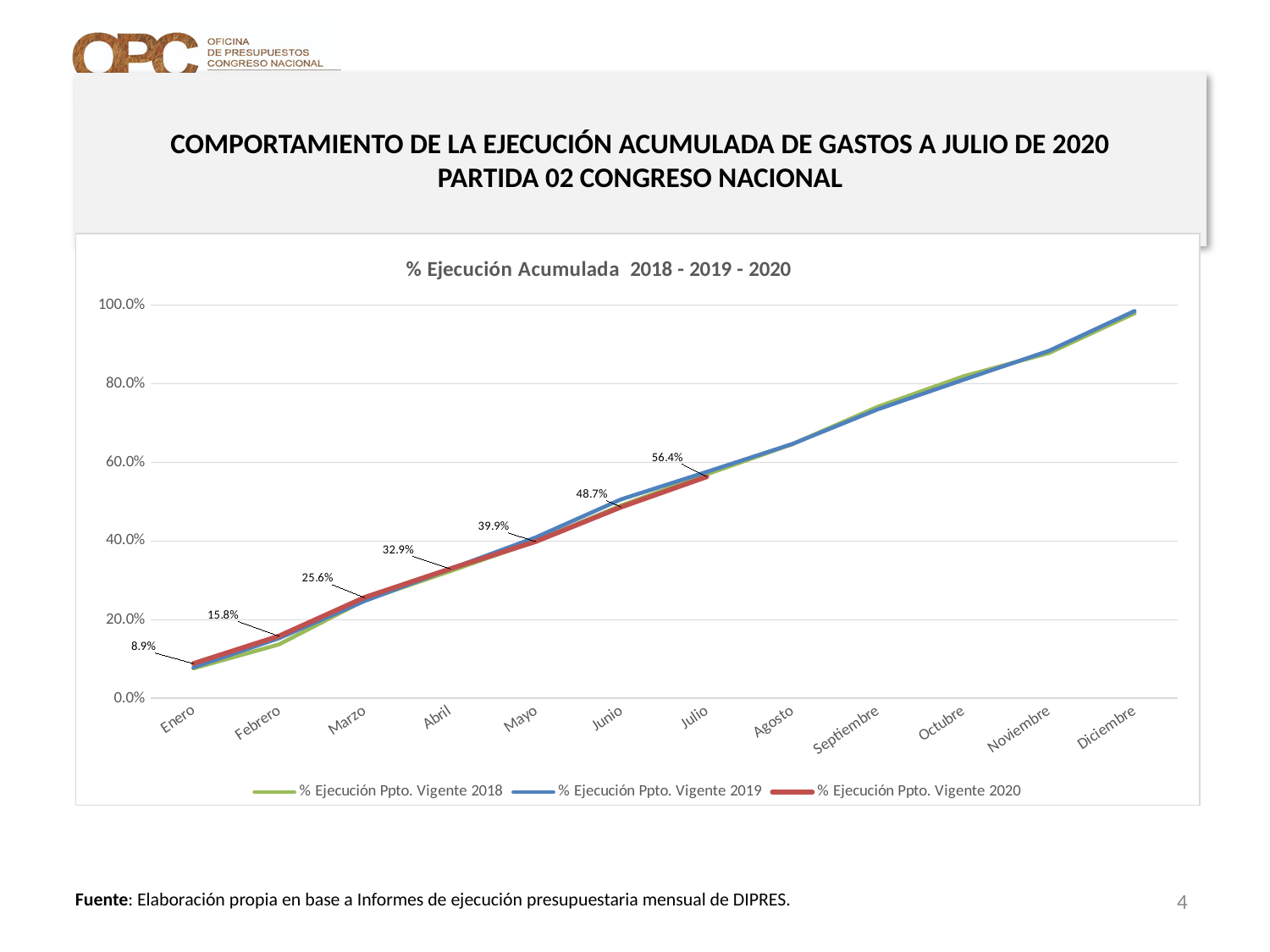
What is the difference between the 2020 values for Julio and Junio? 7.7% How many series does the legend list? 3 What is the difference between the 2020 values for Febrero and Enero? 6.9% Do the values for % Ejecución Ppto. Vigente 2019 rise or fall from Enero to Diciembre? Rise What is the value for % Ejecución Ppto. Vigente 2020 in Enero? 8.9% What is the value for % Ejecución Ppto. Vigente 2020 in Julio? 56.4% Is the value for % Ejecución Ppto. Vigente 2019 in Diciembre greater or less than 80.0%? greater What is the value for % Ejecución Ppto. Vigente 2020 in Marzo? 25.6% What is the value for % Ejecución Ppto. Vigente 2020 in Mayo? 39.9% What is the title of the chart? % Ejecución Acumulada 2018 - 2019 - 2020 What kind of chart is shown on the slide? Line chart How many months are shown on the x axis? 12